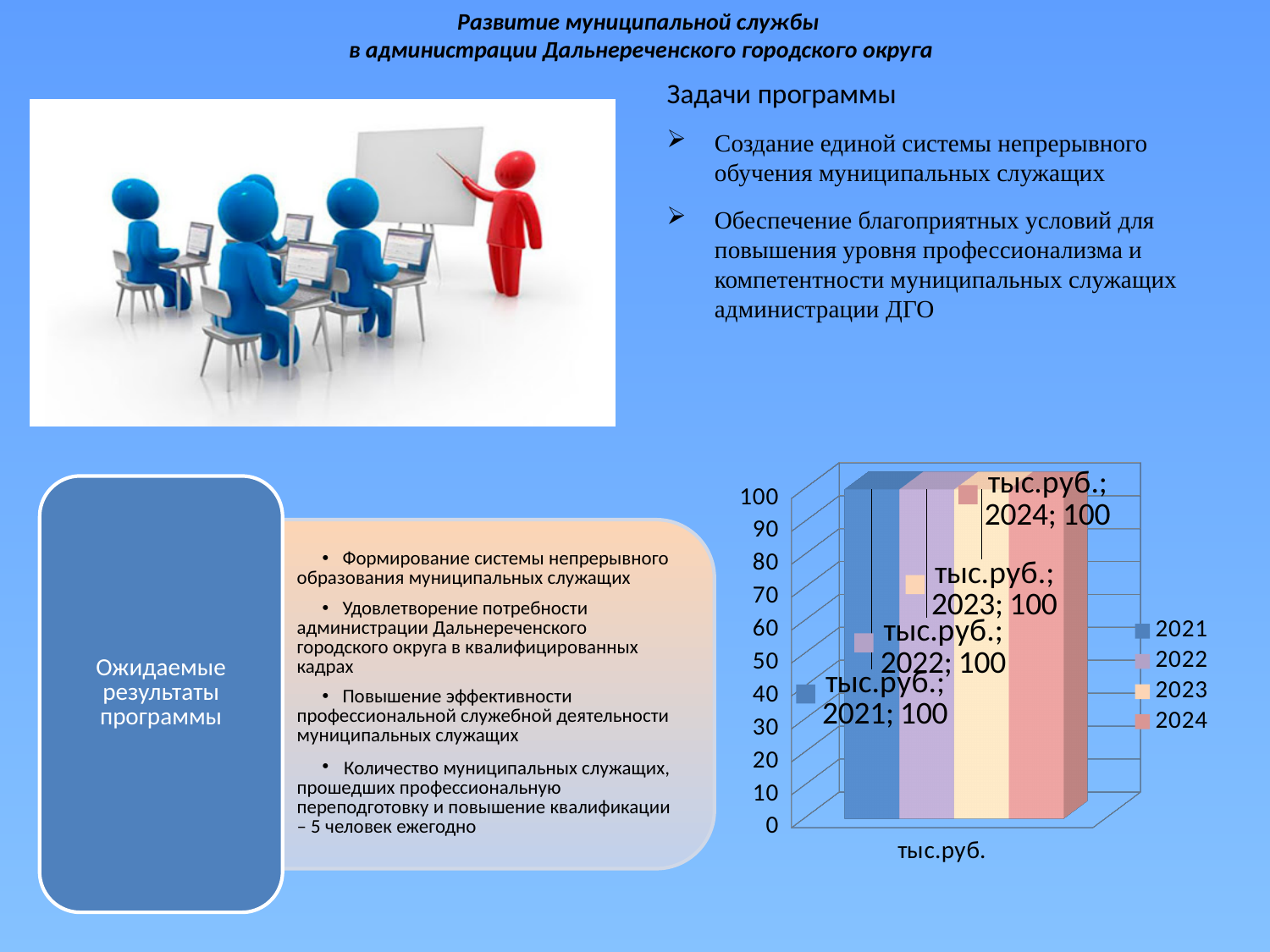
What is the category label shown on the x axis of the chart? тыс.руб. What type of chart is shown on the slide? bar chart Which years are listed in the chart legend? 2021, 2022, 2023, 2024 What is the difference between the values for 2021 and 2024? 0 What is the value for 2024 in the chart? 100 How many series does the chart legend list? 4 What is the highest value shown on the chart's vertical axis? 100 What is the value for 2021 in the chart? 100 Is the value for 2022 greater or less than 50? greater What is the value for 2023 in the chart? 100 What is the value for 2022 in the chart? 100 How many categories are shown on the x axis of the chart? 1